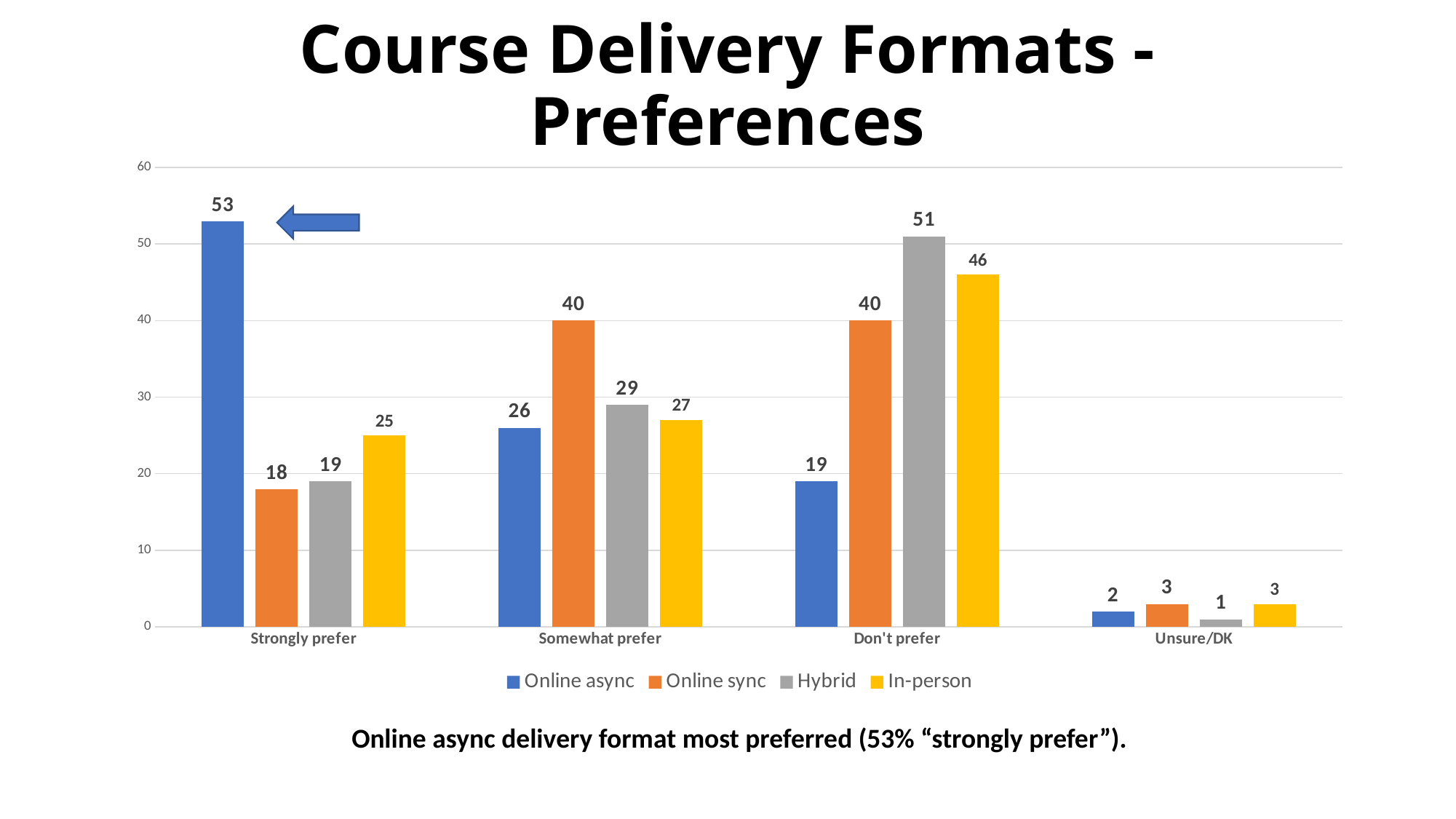
Which series has the lowest value in the Unsure/DK category? Hybrid Which series has the highest value in the Strongly prefer category? Online async Which is larger in the Don't prefer category: Hybrid or In-person? Hybrid What is the value for Hybrid in the Don't prefer category? 51 What kind of chart is shown on the slide? Bar chart How many series does the legend list? 4 Which series is shown in yellow in the legend? In-person What is the difference between the Online async and Online sync values in the Strongly prefer category? 35 What is the value for Online async in the Strongly prefer category? 53 How many categories are shown on the x axis? 4 What is the title of the chart? Course Delivery Formats - Preferences What is the value for In-person in the Somewhat prefer category? 27